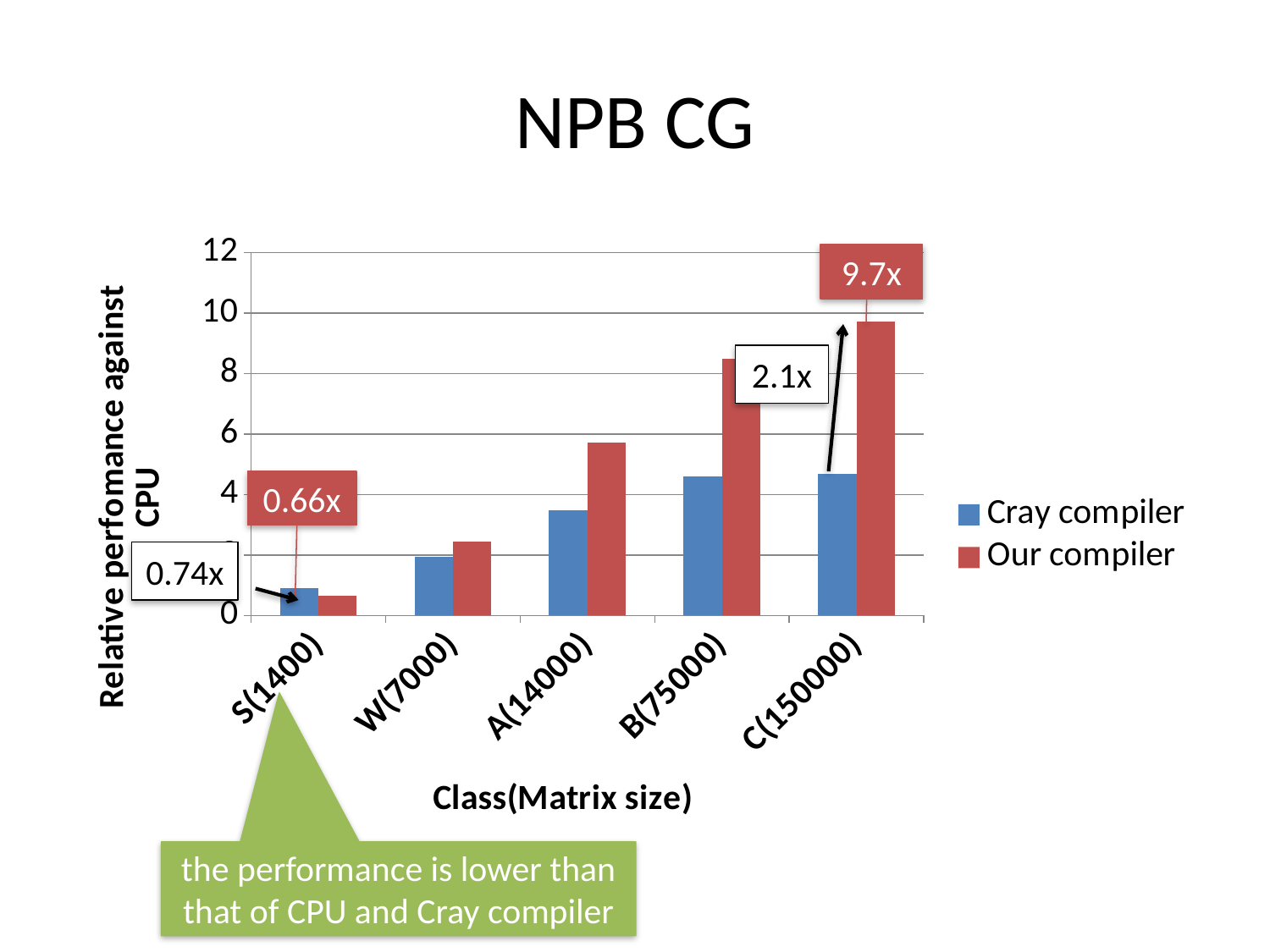
How many series does the legend list? 2 For which class is the Our compiler bar highest? C(150000) What kind of chart is shown on the slide? bar chart Is the value for Our compiler at class B(75000) greater or less than 8? greater How many classes (categories) are shown on the x axis? 5 What is the relative performance of Our compiler for class S(1400)? 0.66x For which class is the Our compiler bar lowest? S(1400) For class B(75000), which series has the larger value, Cray compiler or Our compiler? Our compiler What is the relative performance of Our compiler for class C(150000)? 9.7x What is the title of the x axis? Class(Matrix size) Is the value for the Cray compiler at class A(14000) greater or less than 4? less